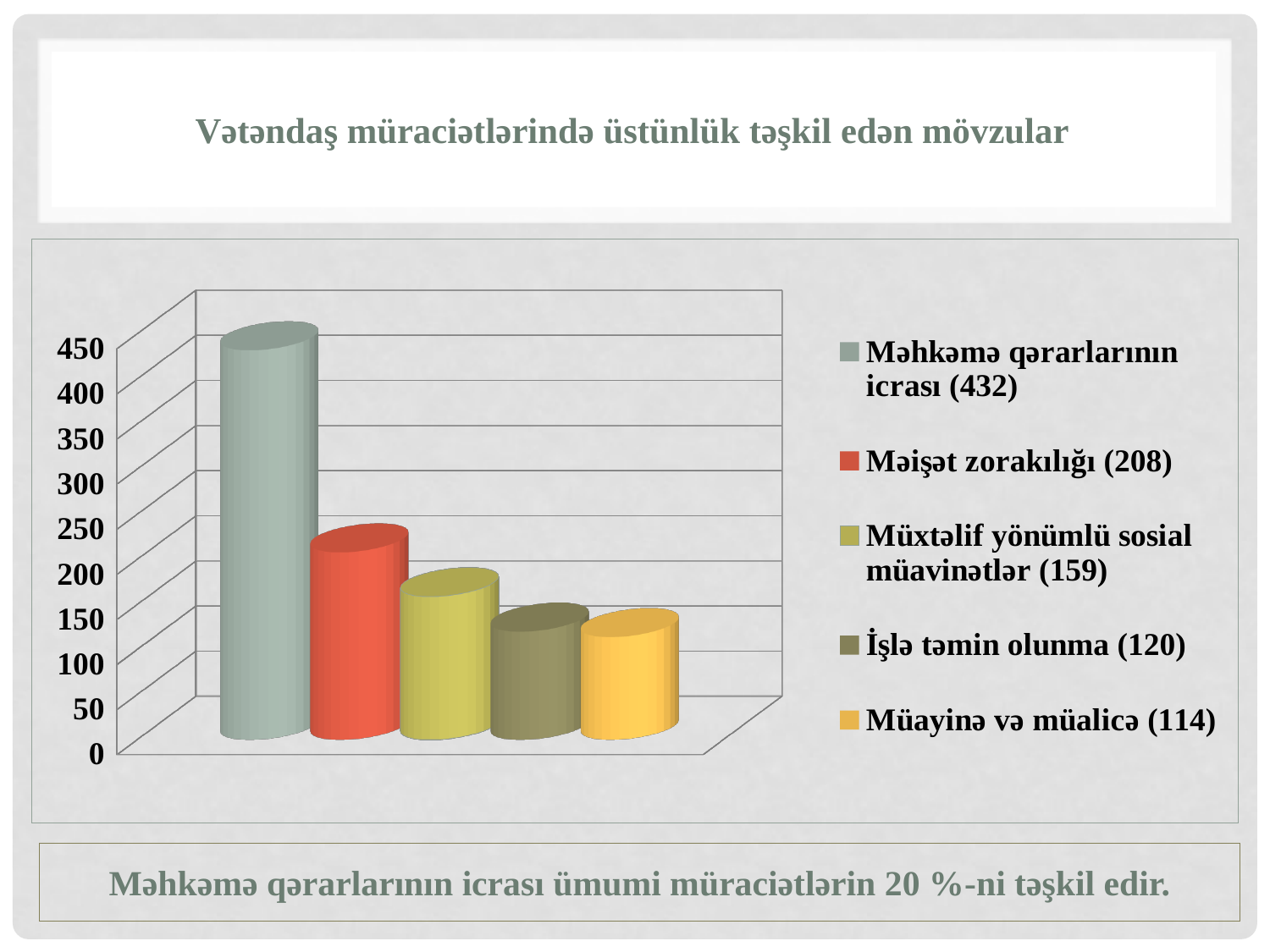
What is the title of the chart? Vətəndaş müraciətlərində üstünlük təşkil edən mövzular What is the difference between the values for Məhkəmə qərarlarının icrası and Məişət zorakılığı? 224 What value is shown for Məhkəmə qərarlarının icrası? 432 What value is shown for İşlə təmin olunma? 120 Is the value for Məhkəmə qərarlarının icrası greater or less than 400? greater Which is larger, the value for Məişət zorakılığı or the value for Müxtəlif yönümlü sosial müavinətlər? Məişət zorakılığı Which category has the lowest value? Müayinə və müalicə Which category has the highest value? Məhkəmə qərarlarının icrası What is the difference between the values for Müxtəlif yönümlü sosial müavinətlər and İşlə təmin olunma? 39 What value is shown for Məişət zorakılığı? 208 What kind of chart is shown on the slide? bar chart How many categories are plotted in the chart? 5